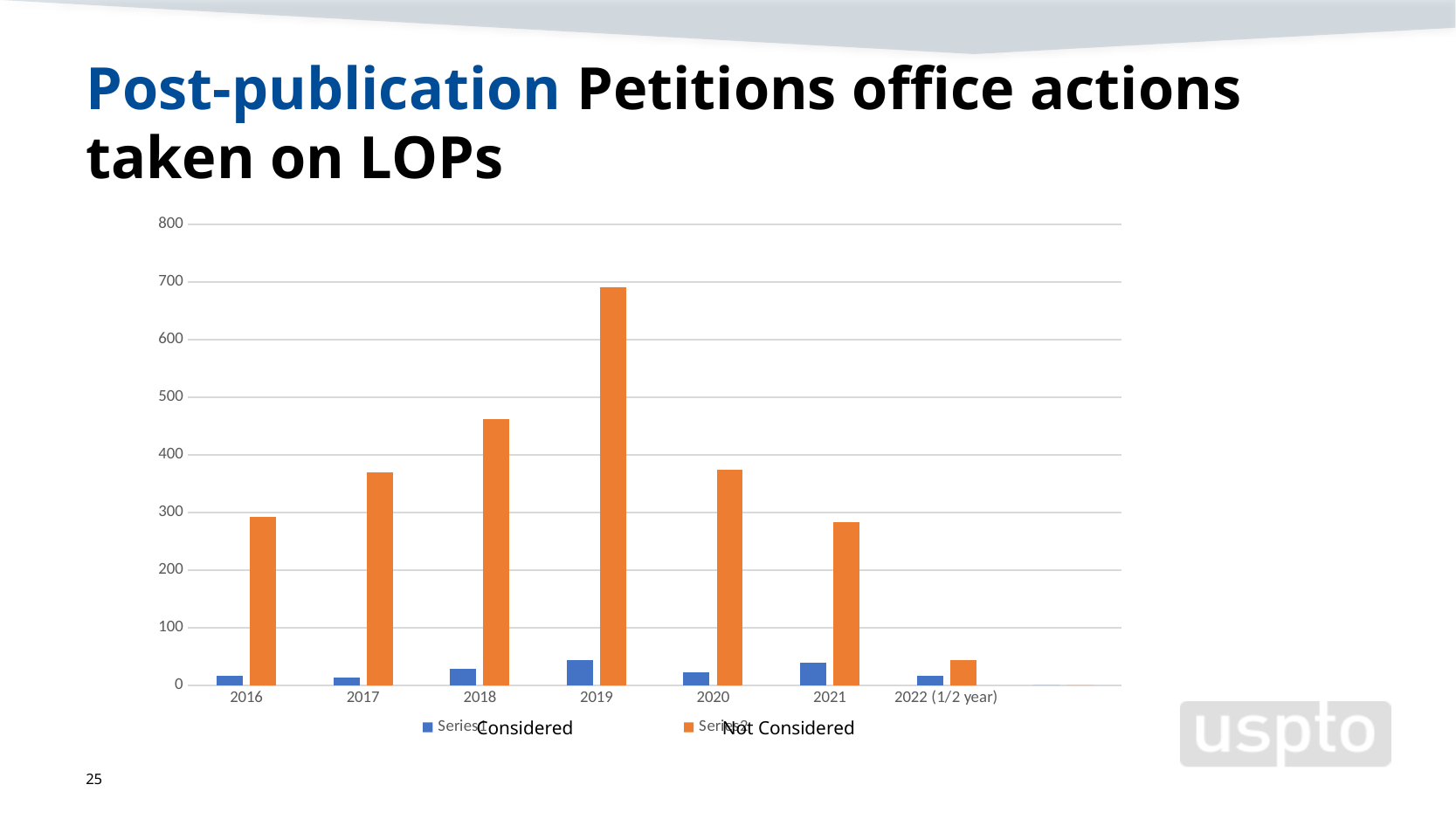
In which year is the Not Considered value highest? 2019 Is the Not Considered value for 2019 greater or less than 600? greater In which category is the Not Considered value lowest? 2022 (1/2 year) Is the Not Considered value for 2017 greater or less than 400? less Which is larger, the Not Considered value for 2018 or for 2017? 2018 Which colour represents the Not Considered series? Orange Is the Considered value for 2019 greater or less than 100? less How many series does the legend list? 2 What kind of chart is shown on the slide? Bar chart How many year categories are shown on the x axis? 7 Do the Not Considered values rise or fall from 2016 to 2019? rise